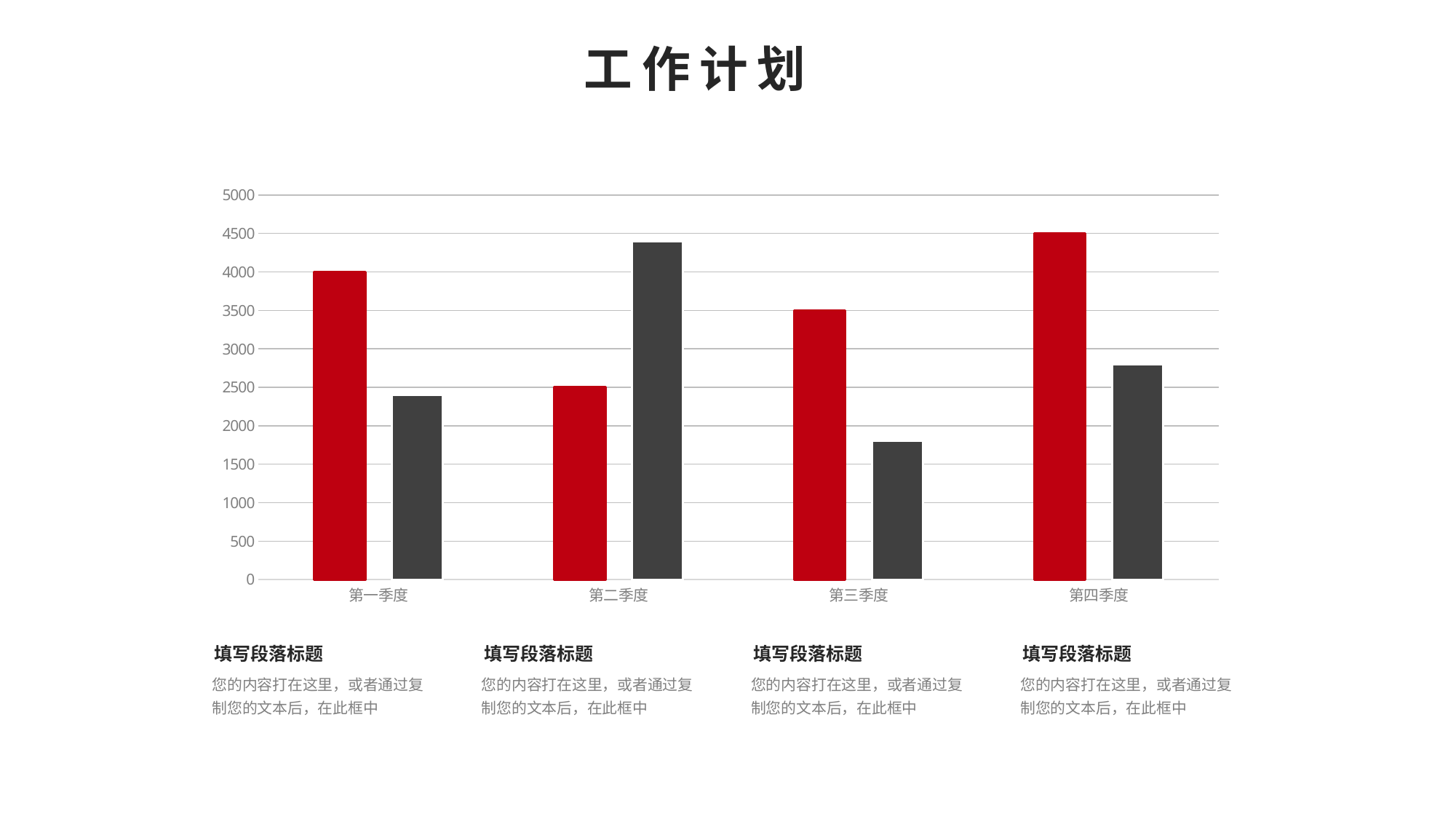
Which category has the tallest red bar? 第四季度 What value does the red bar for 第一季度 reach on the y axis? 4000 What kind of chart is shown on the slide? bar chart For 第二季度, which bar is taller, the red bar or the dark grey bar? the dark grey bar Is the dark grey bar for 第二季度 greater or less than 4000? greater Which category has the shortest red bar? 第二季度 How many categories are shown on the x axis of the chart? 4 What is the title of the slide containing the chart? 工作计划 Is the dark grey bar for 第三季度 greater or less than 2000? less Which category has the shortest dark grey bar? 第三季度 Is the dark grey bar for 第四季度 greater or less than 2500? greater Which category has the tallest dark grey bar? 第二季度